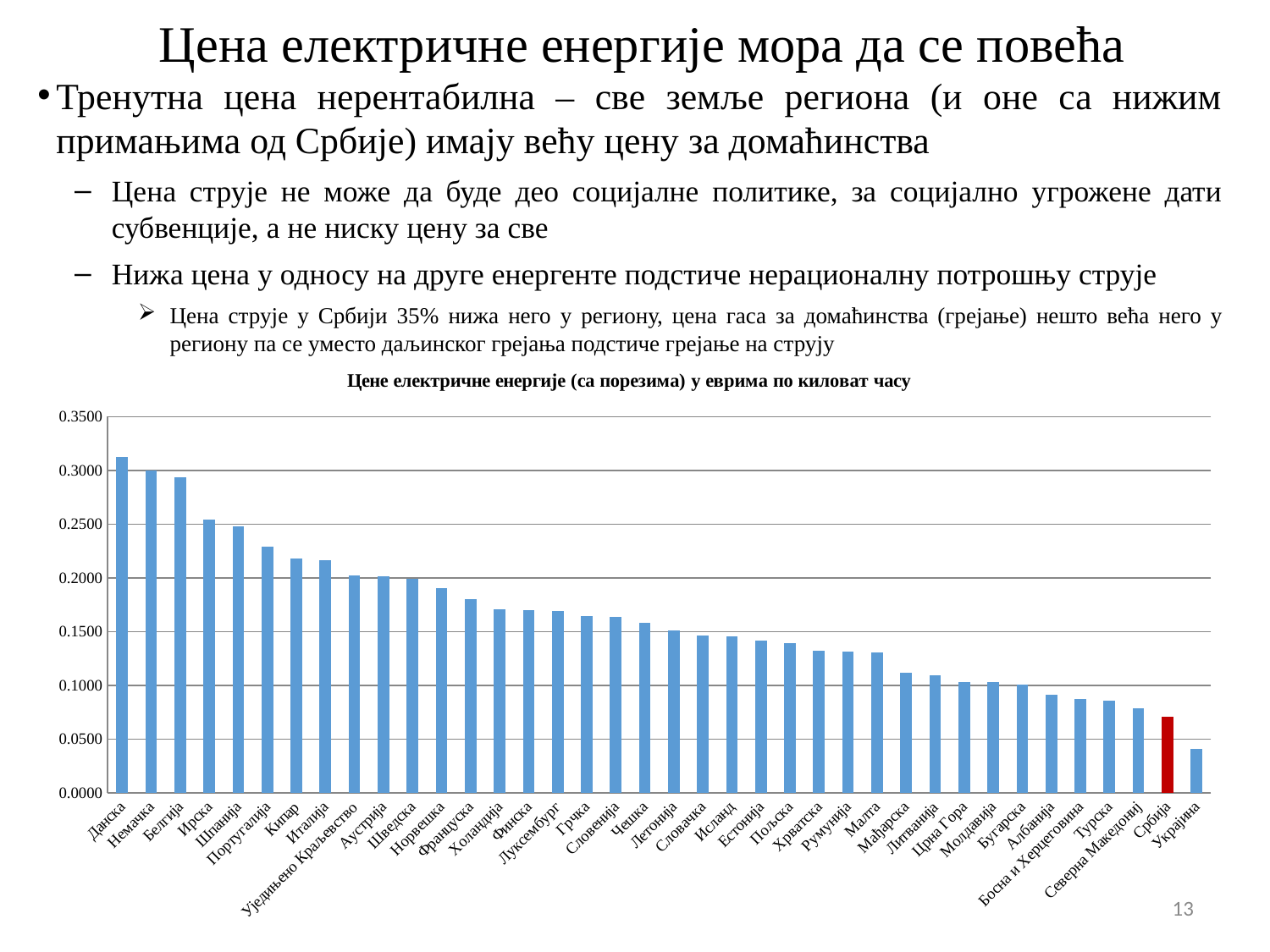
How many countries are shown in the chart? 38 Is the value for Србија greater or less than 0.0500? greater Is the value for Украјина greater or less than 0.0500? less Which country has the lowest electricity price in the chart? Украјина Is the value for Турска greater or less than 0.1000? less Which country has the highest electricity price in the chart? Данска What is the title of the chart? Цене електричне енергије (са порезима) у еврима по киловат часу Which country's bar is coloured red in the chart? Србија Do the values rise or fall from left to right along the x axis? fall Which has the larger value, Србија or Украјина? Србија What kind of chart is shown on the slide? bar chart